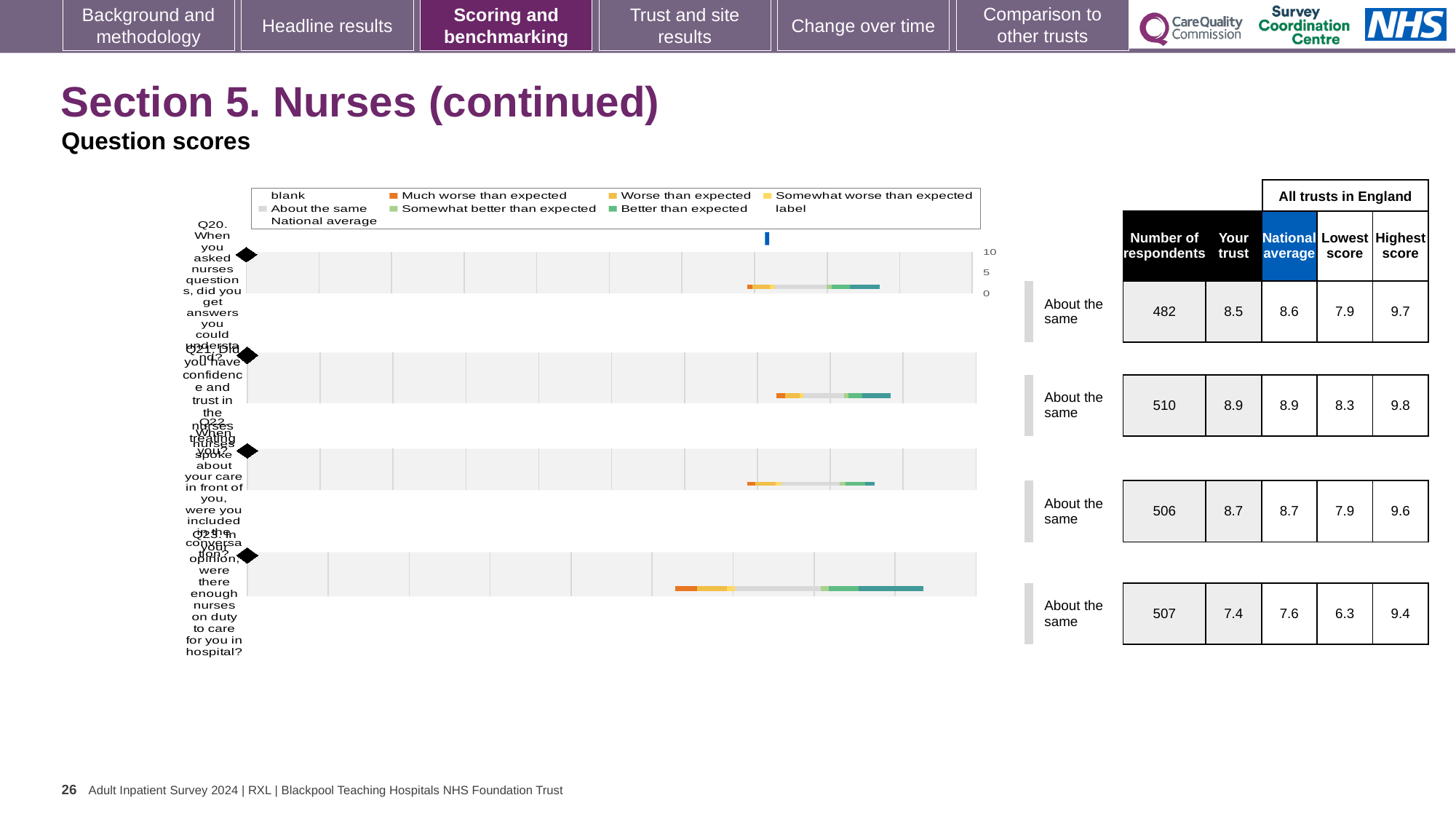
What is the national average score for Q20? 8.6 What benchmark category is shown for Q22? About the same What is the highest score across all trusts in England for Q21? 9.8 Which question has the highest 'Your trust' score? Q21 For Q20, which is larger: the 'Your trust' score or the national average? National average How many respondents answered Q21? 510 Which question has the lowest 'Your trust' score? Q23 For Q23, what is the difference between the highest score (9.4) and the lowest score (6.3) across all trusts in England? 3.1 What is the 'Your trust' score for Q23 (were there enough nurses on duty)? 7.4 What is the maximum value shown on the chart's score axis? 10 What type of chart is used to show the question scores on this slide? bar chart How many questions (Q20 to Q23) are plotted in the chart? 4